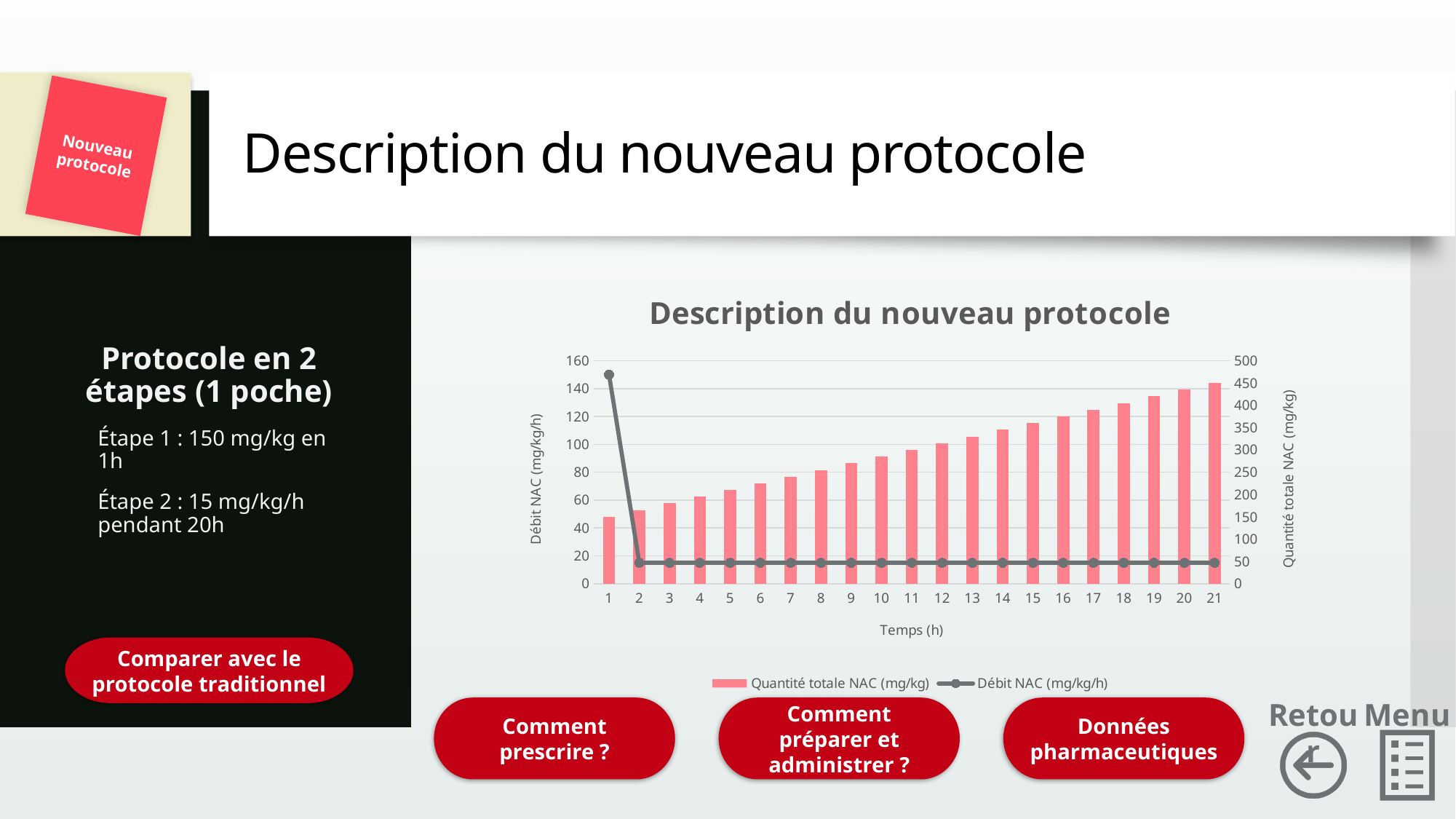
Is the Quantité totale NAC (mg/kg) value at hour 21 greater or less than 400? greater At which hour is the Débit NAC (mg/kg/h) highest? 1 Is the Quantité totale NAC (mg/kg) value at hour 1 greater or less than 200? less At which hour is the Quantité totale NAC (mg/kg) highest? 21 Is the Débit NAC (mg/kg/h) value at hour 1 greater or less than 140? greater Which is larger, the Débit NAC (mg/kg/h) at hour 1 or at hour 2? Hour 1 How many time points (hours) are plotted along the x axis? 21 Do the Quantité totale NAC (mg/kg) bars rise or fall as time increases along the x axis? Rise What kind of chart is shown on the slide? A combination of a bar chart and a line chart How many series does the chart legend list? 2 What is the label of the x axis of the chart? Temps (h)